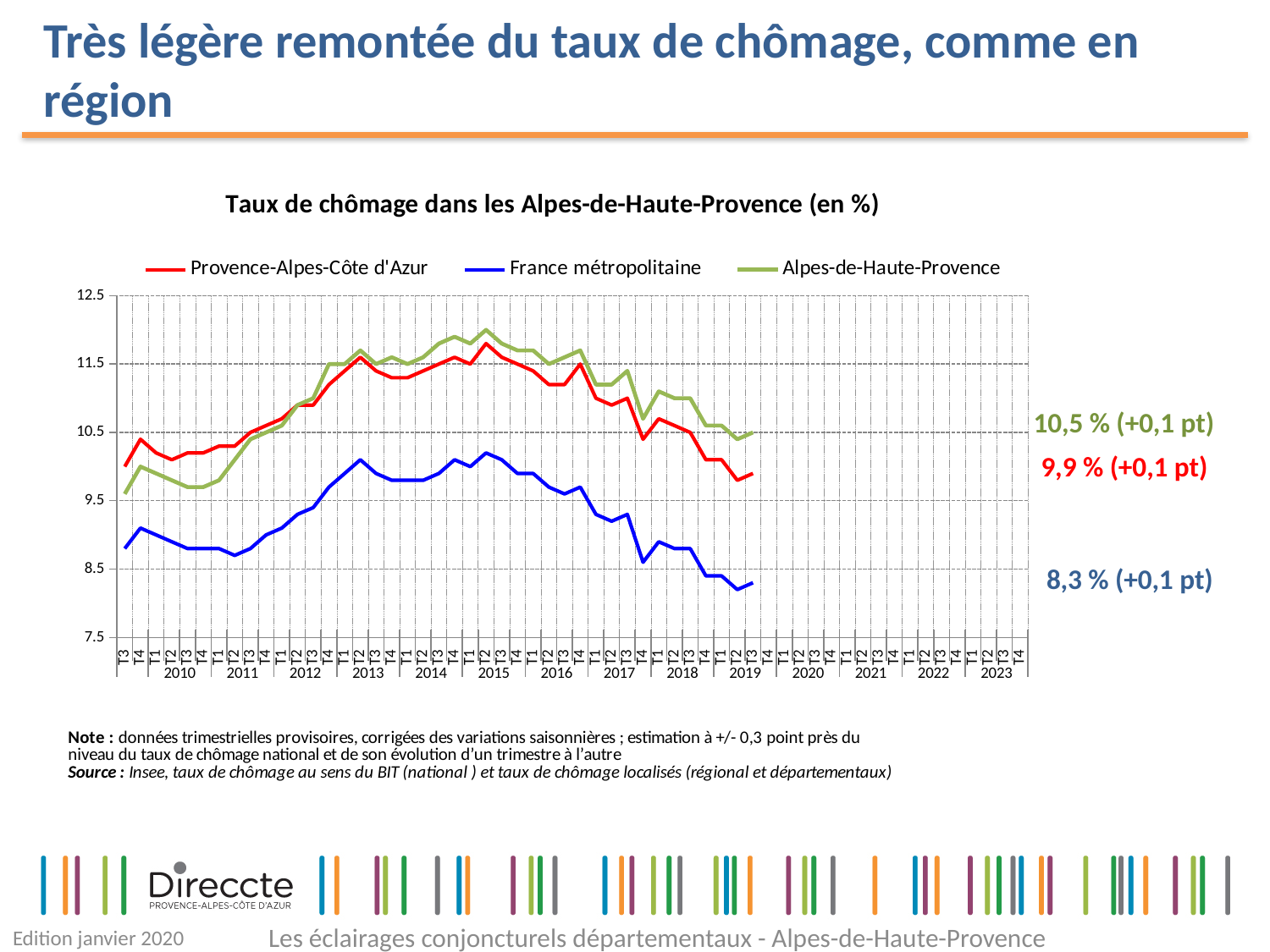
What kind of chart is shown on the slide? line chart Is the value for France métropolitaine in T2 2015 greater or less than 9.5? greater What is the latest unemployment rate shown for Alpes-de-Haute-Provence? 10,5 % Does the France métropolitaine line rise or fall between 2015 and 2019? fall What is the latest unemployment rate shown for France métropolitaine? 8,3 % What is the difference between the latest rates for Alpes-de-Haute-Provence and France métropolitaine? 2,2 pt Which series has the lowest value at the latest point shown? France métropolitaine How many series does the legend list? 3 Which series has the highest value at the latest point shown? Alpes-de-Haute-Provence What is the title of the chart? Taux de chômage dans les Alpes-de-Haute-Provence (en %) By how much did the Alpes-de-Haute-Provence rate change over the last quarter, according to the annotation? +0,1 pt What is the latest unemployment rate shown for Provence-Alpes-Côte d'Azur? 9,9 %